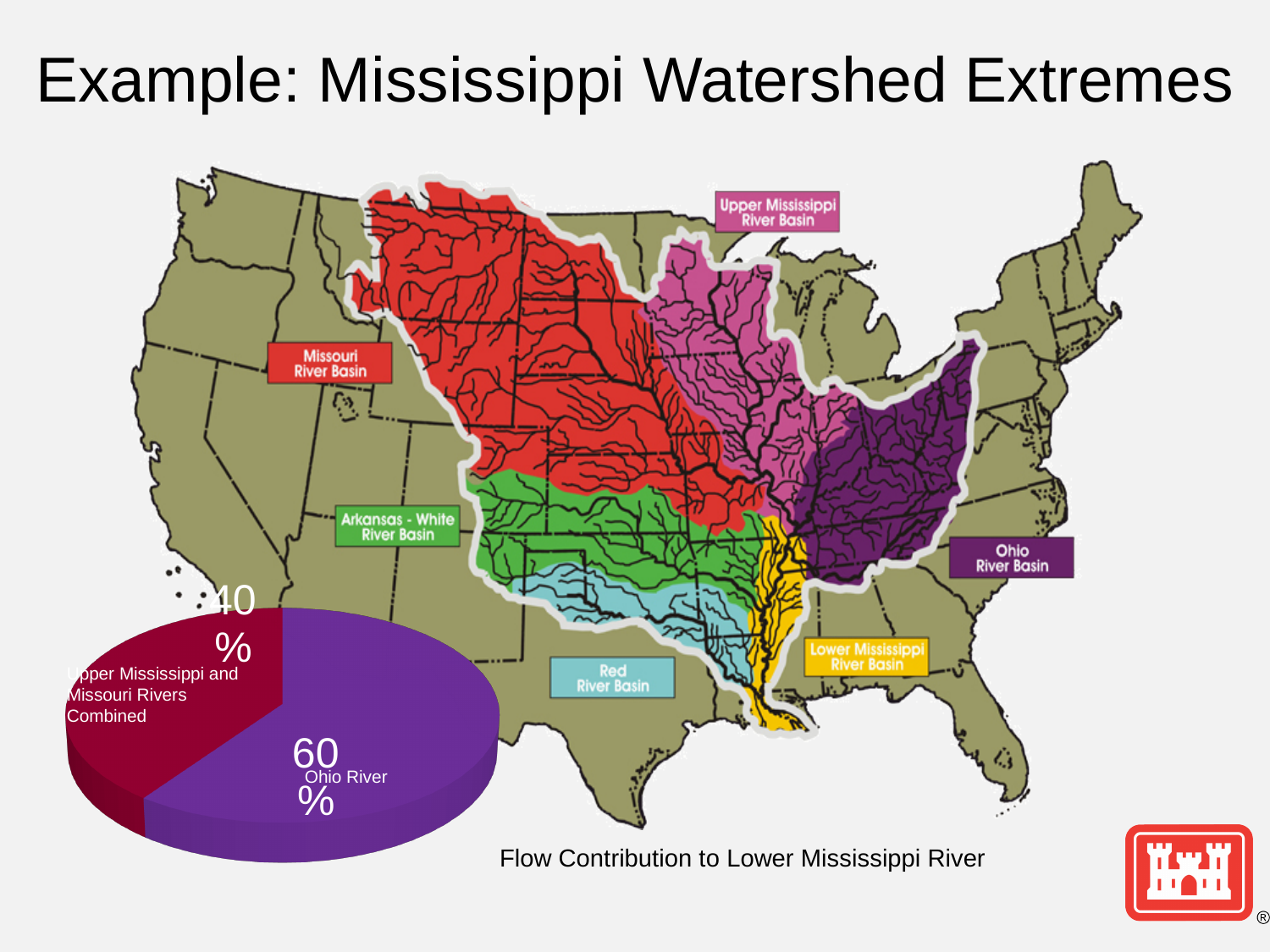
How many slices does the pie chart have? 2 Which slice of the pie chart is the smallest? Upper Mississippi and Missouri Rivers Combined What colour is the Ohio River slice of the pie chart? purple What kind of chart is shown at the bottom left of the slide? pie chart Which slice of the pie chart is the largest? Ohio River What share of flow contribution to the Lower Mississippi River comes from the Ohio River? 60% Which contributes more flow to the Lower Mississippi River, the Ohio River or the Upper Mississippi and Missouri Rivers Combined? Ohio River What is the total of the two pie chart slices? 100% What share of flow contribution to the Lower Mississippi River comes from the Upper Mississippi and Missouri Rivers Combined? 40% What is the caption below the pie chart? Flow Contribution to Lower Mississippi River What is the difference in percentage points between the Ohio River slice and the Upper Mississippi and Missouri Rivers Combined slice? 20